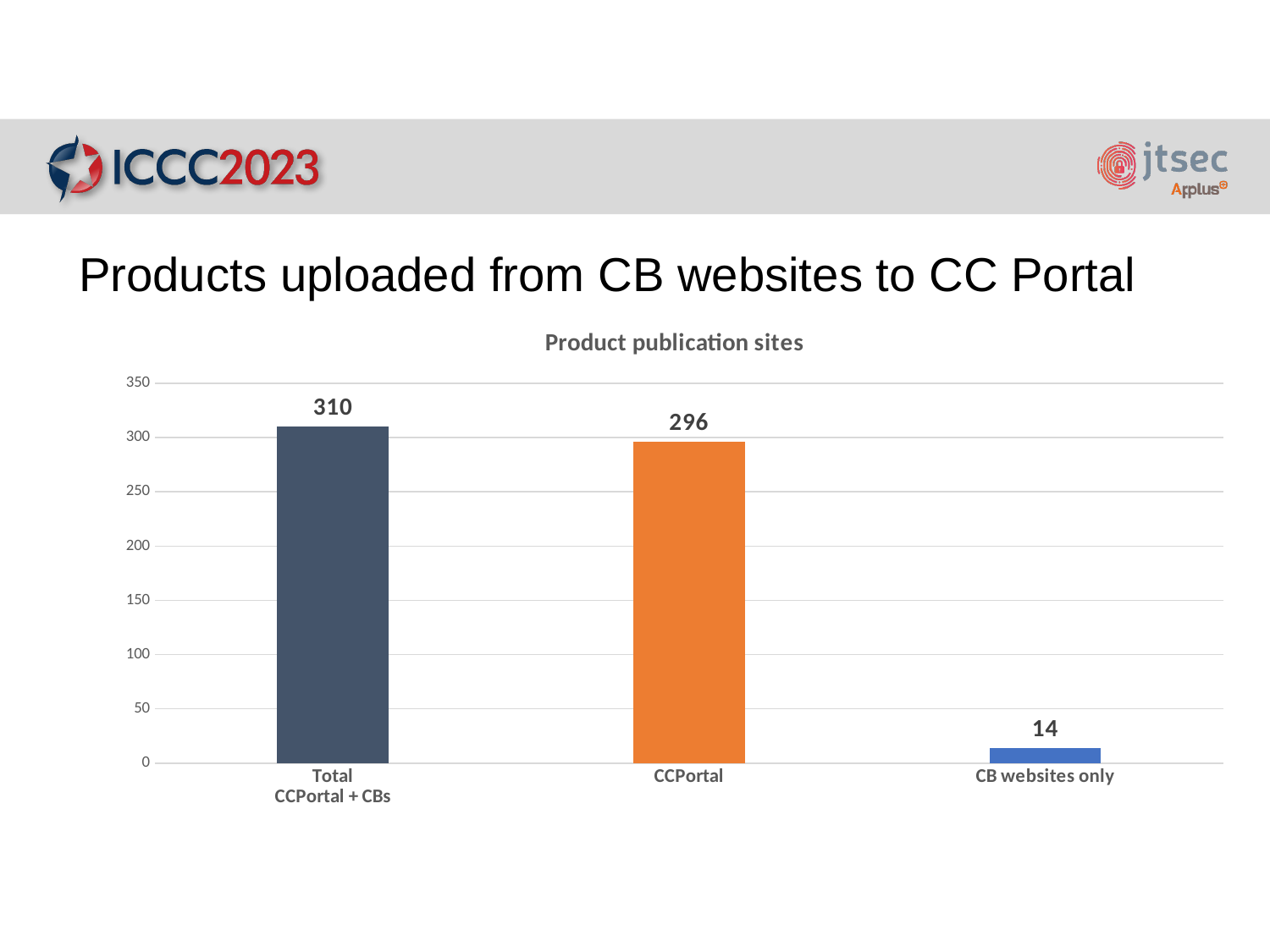
Which category has the highest value? Total CCPortal + CBs What is the title of the chart? Product publication sites How many categories are shown on the chart? 3 Is the value for CCPortal greater or less than 250? greater What is the value for Total CCPortal + CBs? 310 What is the value for CCPortal? 296 What is the difference between the values for Total CCPortal + CBs and CCPortal? 14 What is the difference between the values for CCPortal and CB websites only? 282 What is the value for CB websites only? 14 What kind of chart is shown on the slide? bar chart Which is larger, the value for CCPortal or the value for CB websites only? CCPortal Which category has the lowest value? CB websites only